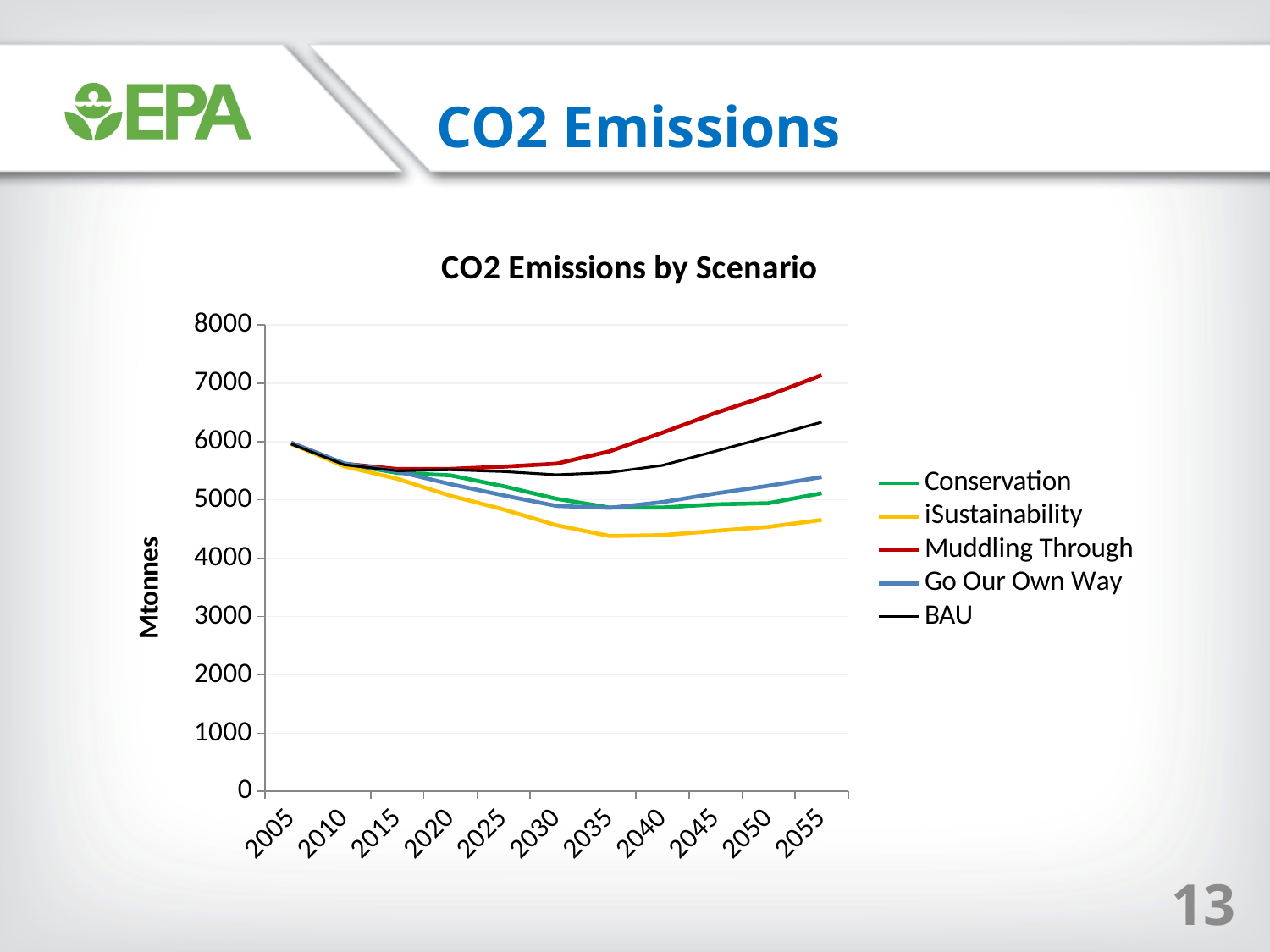
What is the label on the y axis? Mtonnes Does the Muddling Through line rise or fall between 2035 and 2055? rise Is the value for Muddling Through in 2055 greater or less than 6000? greater In 2055, which is larger: BAU or Go Our Own Way? BAU How many years are marked along the x axis? 11 Which scenario has the highest CO2 emissions in 2055? Muddling Through What kind of chart is shown on the slide? line chart Is the value for iSustainability in 2035 greater or less than 5000? less Does the iSustainability line rise or fall between 2005 and 2035? fall How many series does the legend list? 5 Which scenario has the lowest CO2 emissions in 2055? iSustainability Is the value for BAU in 2055 greater or less than 6000? greater